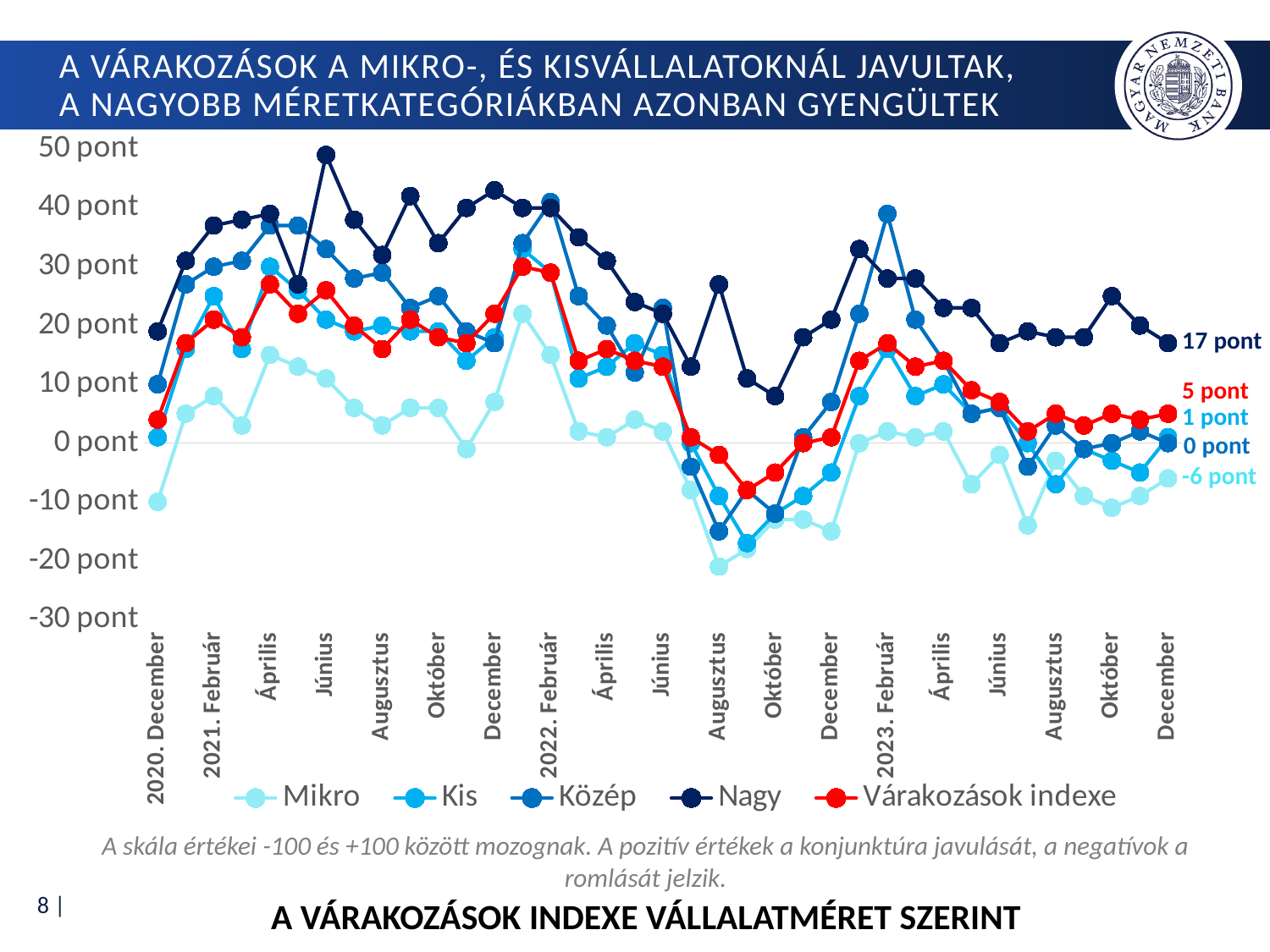
What is the value of the Várakozások indexe series at the end of the chart? 5 pont What is the value of the Nagy series at the end of the chart (December 2023)? 17 pont Is the value of the Nagy series in June 2021 greater or less than 40 pont? greater Which series has the highest value at the end of the chart (December 2023)? Nagy What is the value of the Közép series at the end of the chart? 0 pont Is the value of the Mikro series in August 2022 greater or less than -10 pont? less Which series has the lowest value at the end of the chart (December 2023)? Mikro How many series does the legend list? 5 What kind of chart is shown on the slide? Line chart What is the value of the Kis series at the end of the chart? 1 pont What is the difference between the Nagy and Mikro values at the end of the chart? 23 pont What is the value of the Mikro series at the end of the chart? -6 pont